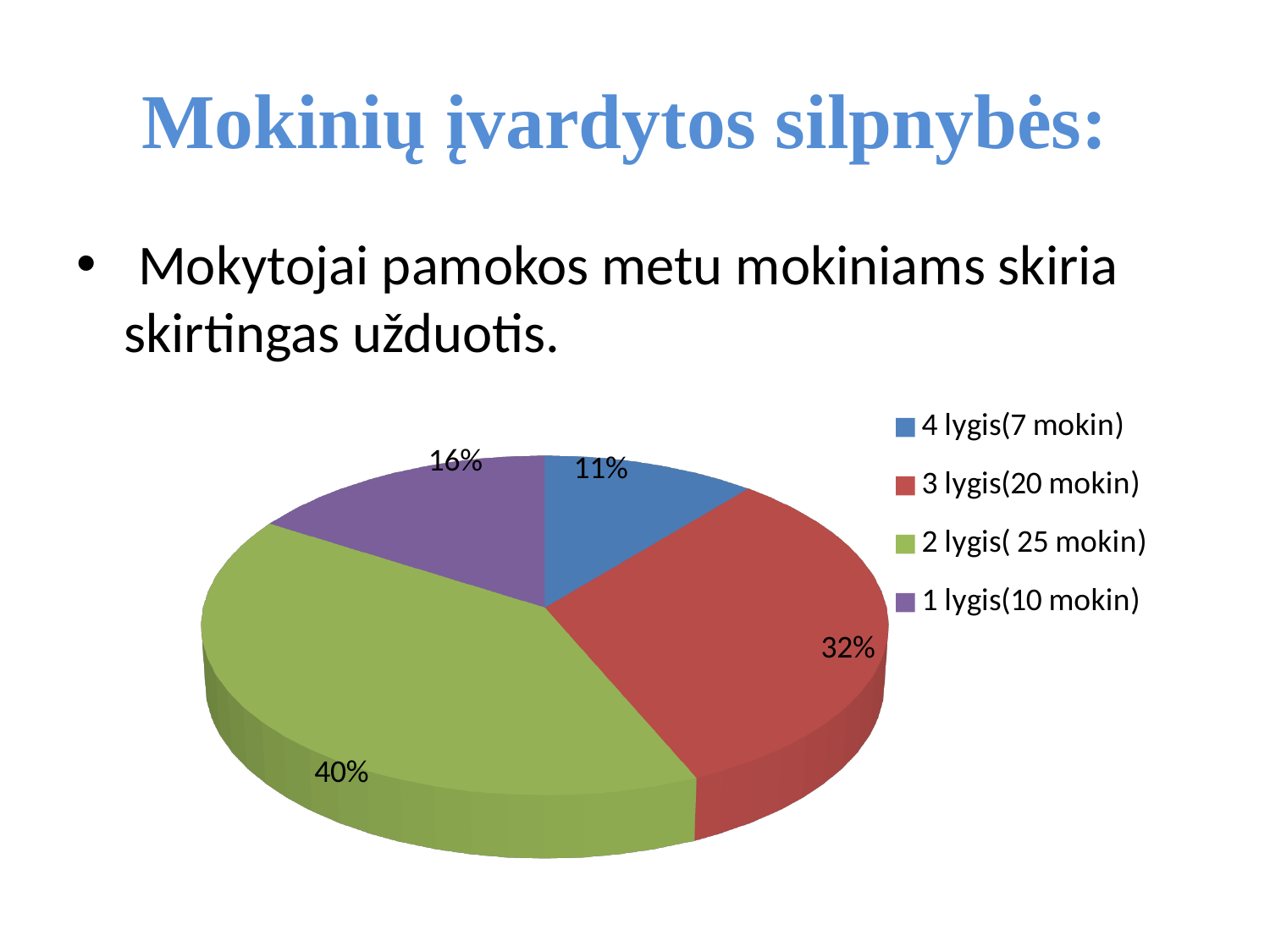
Which category has the largest slice of the pie? 2 lygis( 25 mokin) What percentage of the pie does the slice for "4 lygis(7 mokin)" represent? 11% Which slice is larger: "1 lygis(10 mokin)" or "4 lygis(7 mokin)"? 1 lygis(10 mokin) Which category has the smallest slice of the pie? 4 lygis(7 mokin) What percentage of the pie does the slice for "1 lygis(10 mokin)" represent? 16% What is the difference in percentage points between the "2 lygis( 25 mokin)" slice and the "3 lygis(20 mokin)" slice? 8 What colour is the slice for "3 lygis(20 mokin)"? red How many slices does the pie chart have? 4 How many entries does the legend of the pie chart list? 4 What kind of chart is shown on the slide? pie chart What percentage of the pie does the slice for "2 lygis( 25 mokin)" represent? 40%